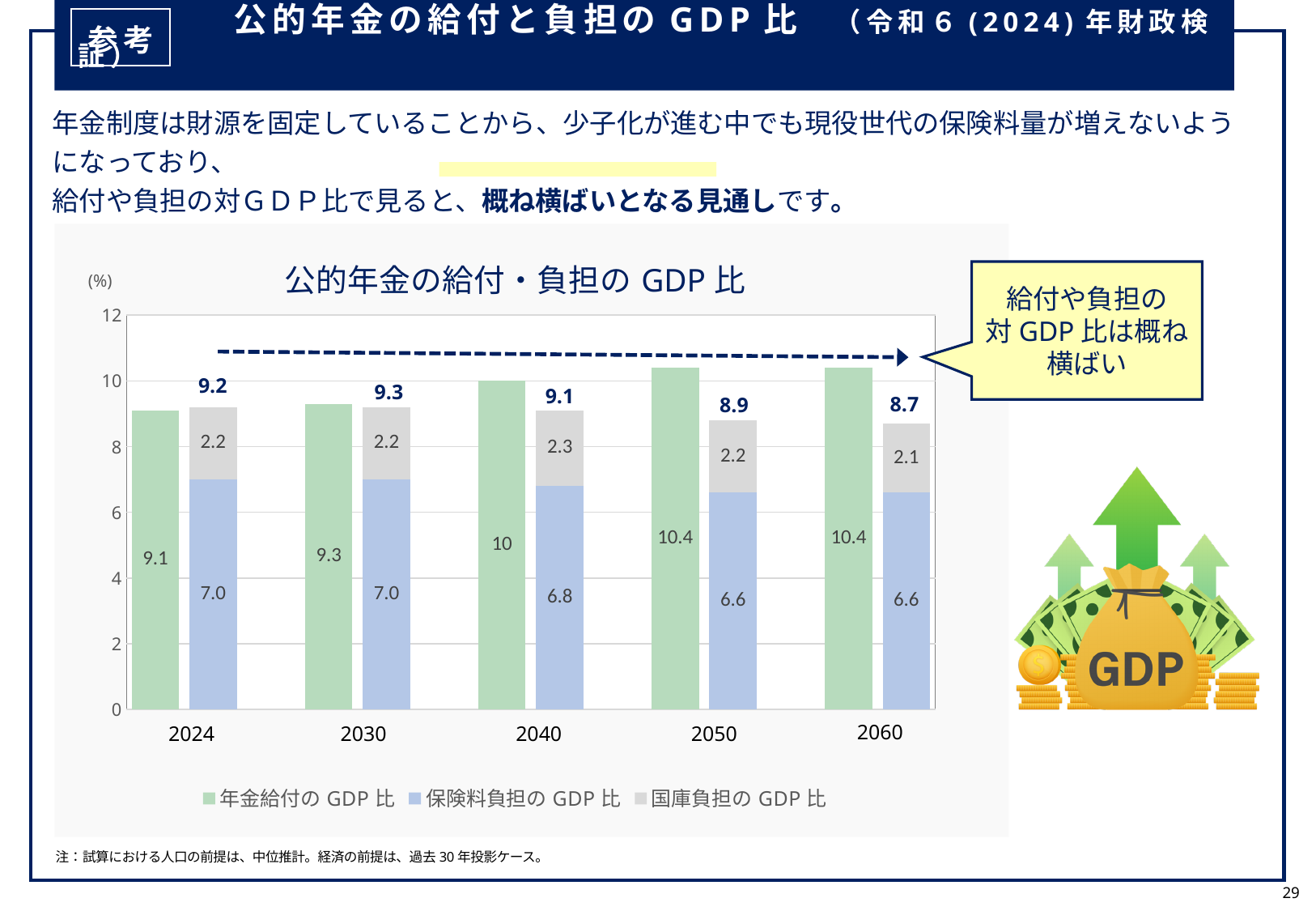
年金給付のGDP比が最も高いのはどの年ですか？ 2050年と2060年（10.4） 2040年の保険料負担のGDP比の値はいくつですか？ 6.8 2060年の国庫負担のGDP比の値はいくつですか？ 2.1 2050年の保険料負担と国庫負担を合わせたGDP比の合計はいくつですか？ 8.9 凡例にはいくつの系列が示されていますか？ 3 2060年と2024年の年金給付のGDP比の差はいくつですか？ 1.3 このグラフはどの種類のグラフですか？ 棒グラフ 2030年の年金給付のGDP比と2040年の年金給付のGDP比では、どちらが大きいですか？ 2040年 2024年の年金給付のGDP比の値はいくつですか？ 9.1 保険料負担のGDP比は2024年から2060年にかけて上昇していますか、下降していますか？ 下降 横軸には何年分のカテゴリがありますか？ 5 保険料負担のGDP比が最も低いのはどの年ですか？ 2050年と2060年（6.6）